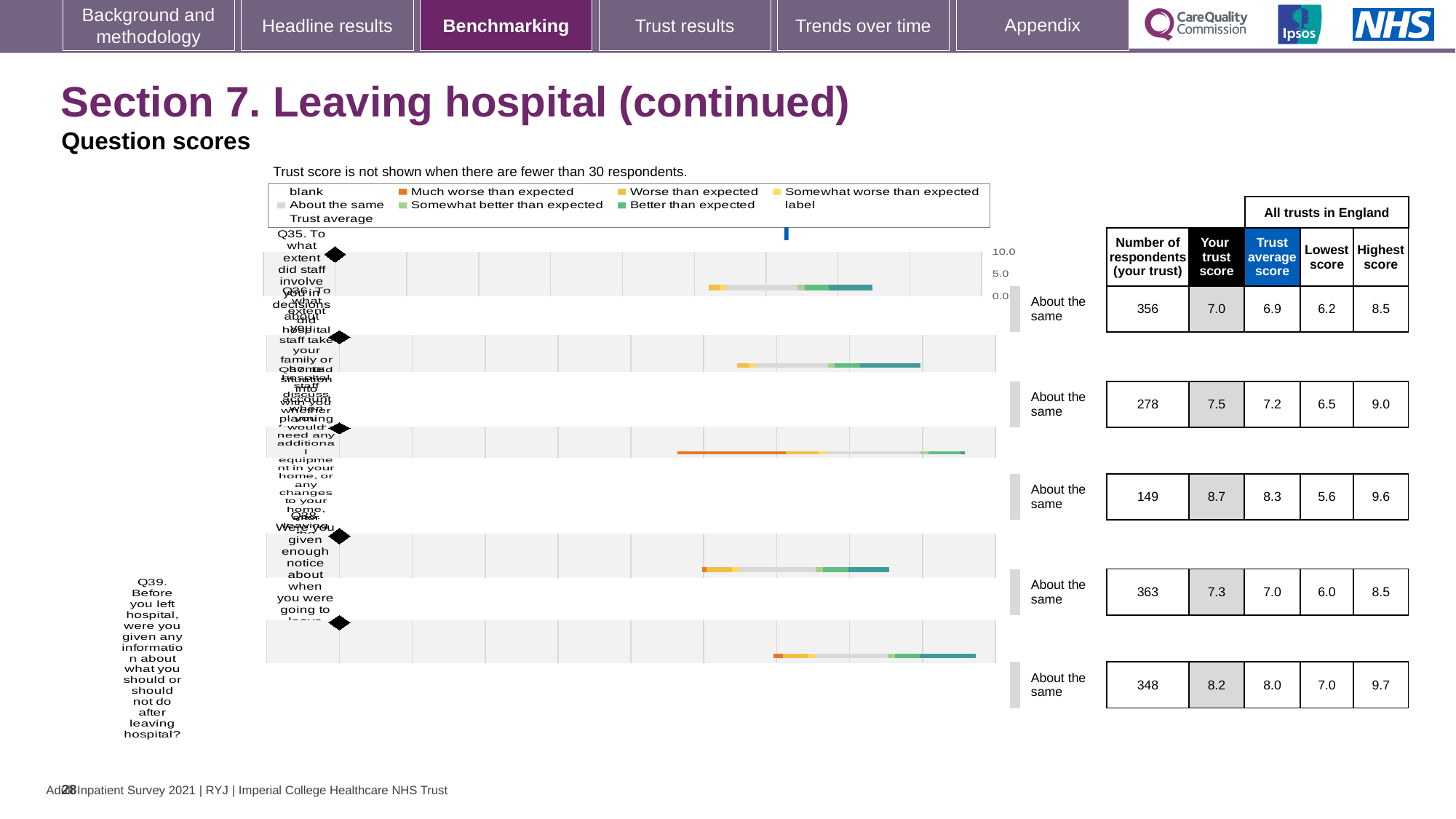
Which row of the table has the highest 'Your trust score'? The third row (8.7) What is the lowest score in England for Q39 (the last row of the table)? 7.0 What is the lowest 'Trust average score' shown in the table? 6.9 For Q35 (the first row), is your trust score higher or lower than the trust average score? Higher What is the highest score in England for the third row of the table (149 respondents)? 9.6 What kind of chart is used to show the question scores? Bar chart What is your trust score for Q39 (the last row of the table)? 8.2 How many respondents from your trust answered Q35 (the first row of the table)? 356 How many questions are plotted in the benchmarking chart? 5 What benchmark category is shown for every question on this slide? About the same What is the difference between your trust score and the trust average score for Q39 (the last row)? 0.2